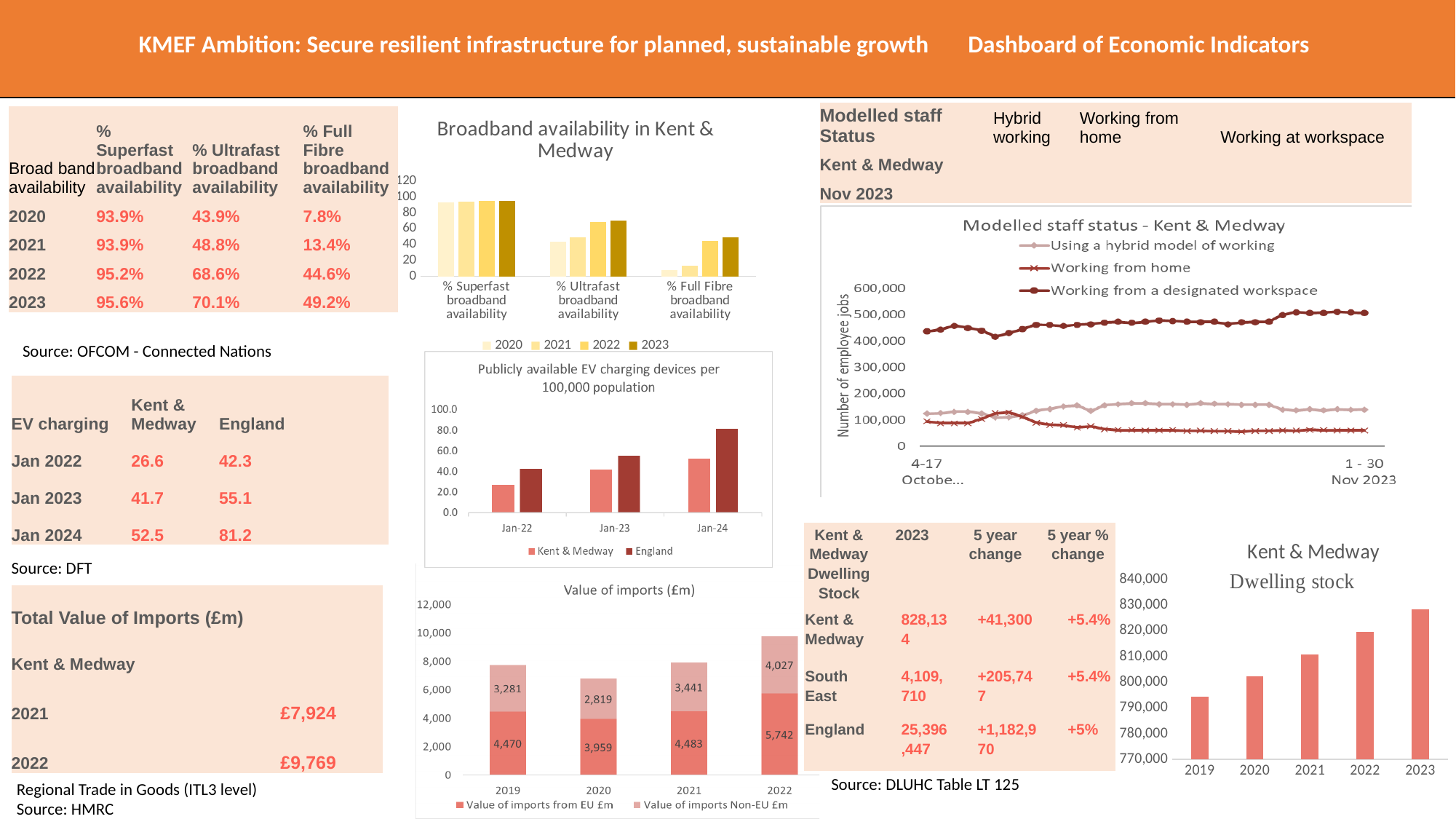
How many series does the legend of the 'Value of imports (£m)' chart list? 2 In the 'Value of imports (£m)' chart, what is the total value of imports for 2021? 7,924 In the 'Modelled staff status - Kent & Medway' chart, is the value for 'Working from a designated workspace' in Nov 2023 greater or less than 400,000? greater In the 'Value of imports (£m)' chart, what is the difference between imports from EU in 2022 and 2021? 1,259 In the 'Value of imports (£m)' chart, what is the value of imports from EU for 2022? 5,742 What kind of chart is 'Modelled staff status - Kent & Medway'? line chart In the 'Kent & Medway Dwelling stock' chart, is the value for 2019 greater or less than 800,000? less In the 'Kent & Medway Dwelling stock' chart, do the values rise or fall from 2019 to 2023? rise How many categories are shown on the x axis of the 'Publicly available EV charging devices per 100,000 population' chart? 3 In the 'Value of imports (£m)' chart, what is the value of imports Non-EU for 2020? 2,819 In the 'Publicly available EV charging devices per 100,000 population' chart, which series is higher at Jan-24, Kent & Medway or England? England In the 'Value of imports (£m)' chart, which year has the lowest total value of imports? 2020